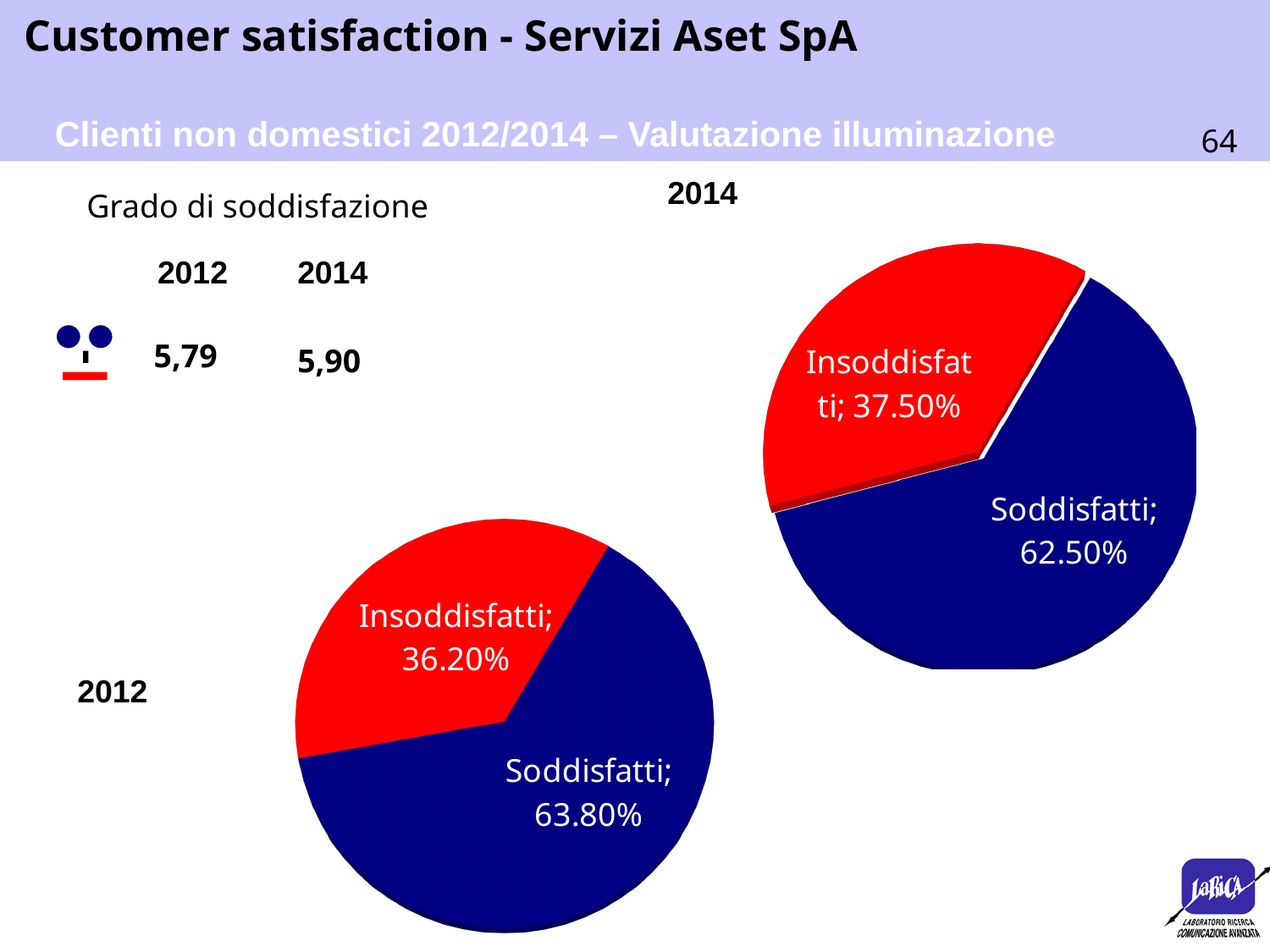
In the 2014 pie chart, what is the value for Soddisfatti? 62.50% In the 2014 pie chart, what is the value for Insoddisfatti? 37.50% In the 2012 pie chart, what is the value for Insoddisfatti? 36.20% In the 2014 pie chart, what colour is the Soddisfatti slice? Dark blue In the 2012 pie chart, what is the value for Soddisfatti? 63.80% How many slices does the 2012 pie chart have? 2 In the 2014 pie chart, which slice is the largest? Soddisfatti Which is larger: the Insoddisfatti share in the 2012 pie chart or in the 2014 pie chart? 2014 In the 2012 pie chart, which slice is the smallest? Insoddisfatti What kind of chart is the 2014 chart? Pie chart In the 2012 pie chart, what is the difference between the Soddisfatti and Insoddisfatti shares? 27.60% In the 2014 pie chart, what is the difference between the Soddisfatti and Insoddisfatti shares? 25.00%